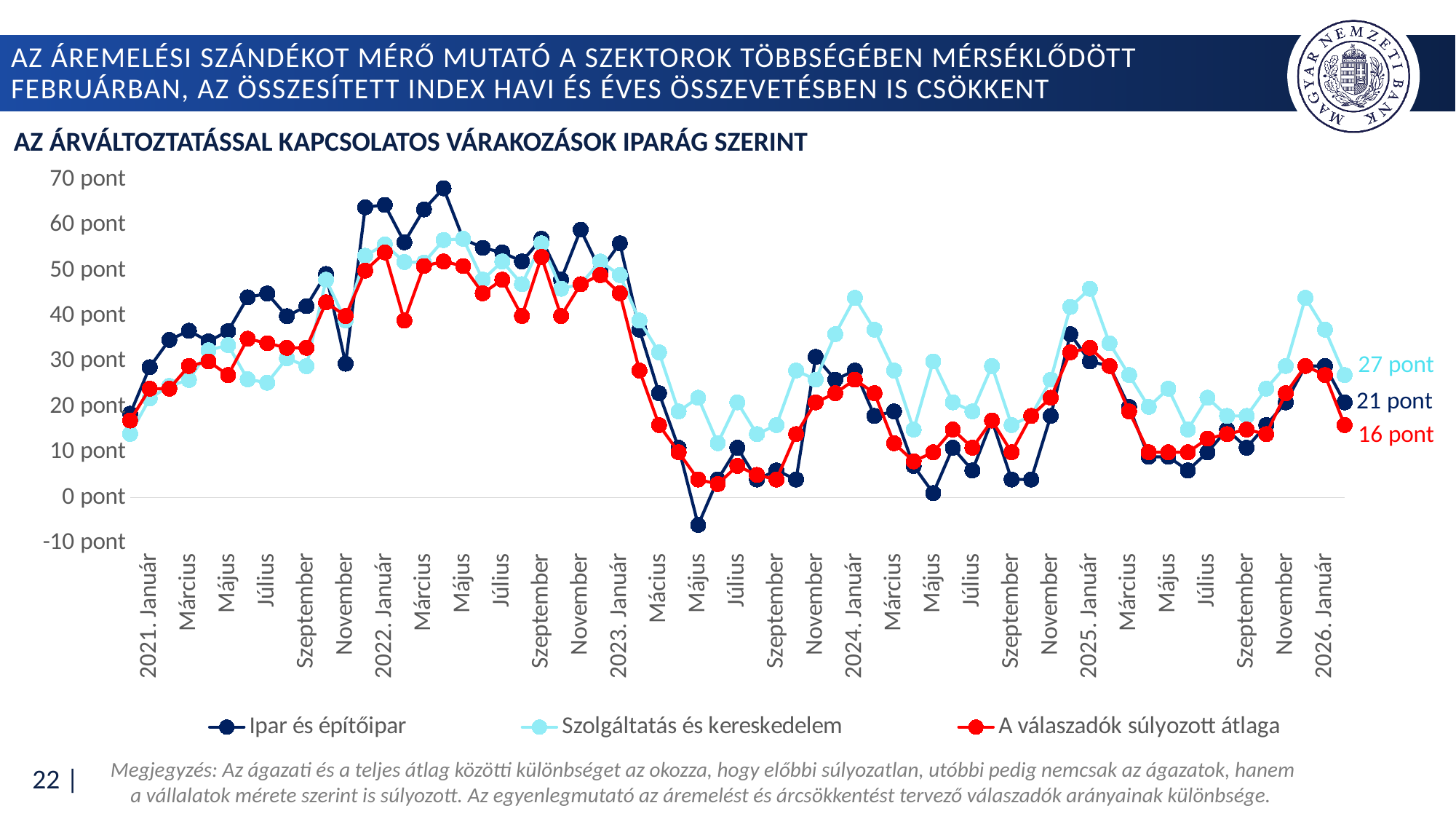
What is the latest value shown for the Ipar és építőipar series? 21 pont What is the latest value shown for the Szolgáltatás és kereskedelem series? 27 pont Is the value for Ipar és építőipar in 2022 Május greater or less than 60 pont? less At the end of the chart, which is larger: the value for Ipar és építőipar or the value for A válaszadók súlyozott átlaga? Ipar és építőipar What type of chart is shown on the slide? line chart Which series has the lowest value at the end of the chart? A válaszadók súlyozott átlaga Is the value for Ipar és építőipar in 2023 Május greater or less than 0 pont? less Which series has the highest value at the end of the chart? Szolgáltatás és kereskedelem What is the latest value shown for the A válaszadók súlyozott átlaga series? 16 pont What is the difference between the latest values of Szolgáltatás és kereskedelem and A válaszadók súlyozott átlaga? 11 pont What is the title of the chart? AZ ÁRVÁLTOZTATÁSSAL KAPCSOLATOS VÁRAKOZÁSOK IPARÁG SZERINT How many series does the legend list? 3